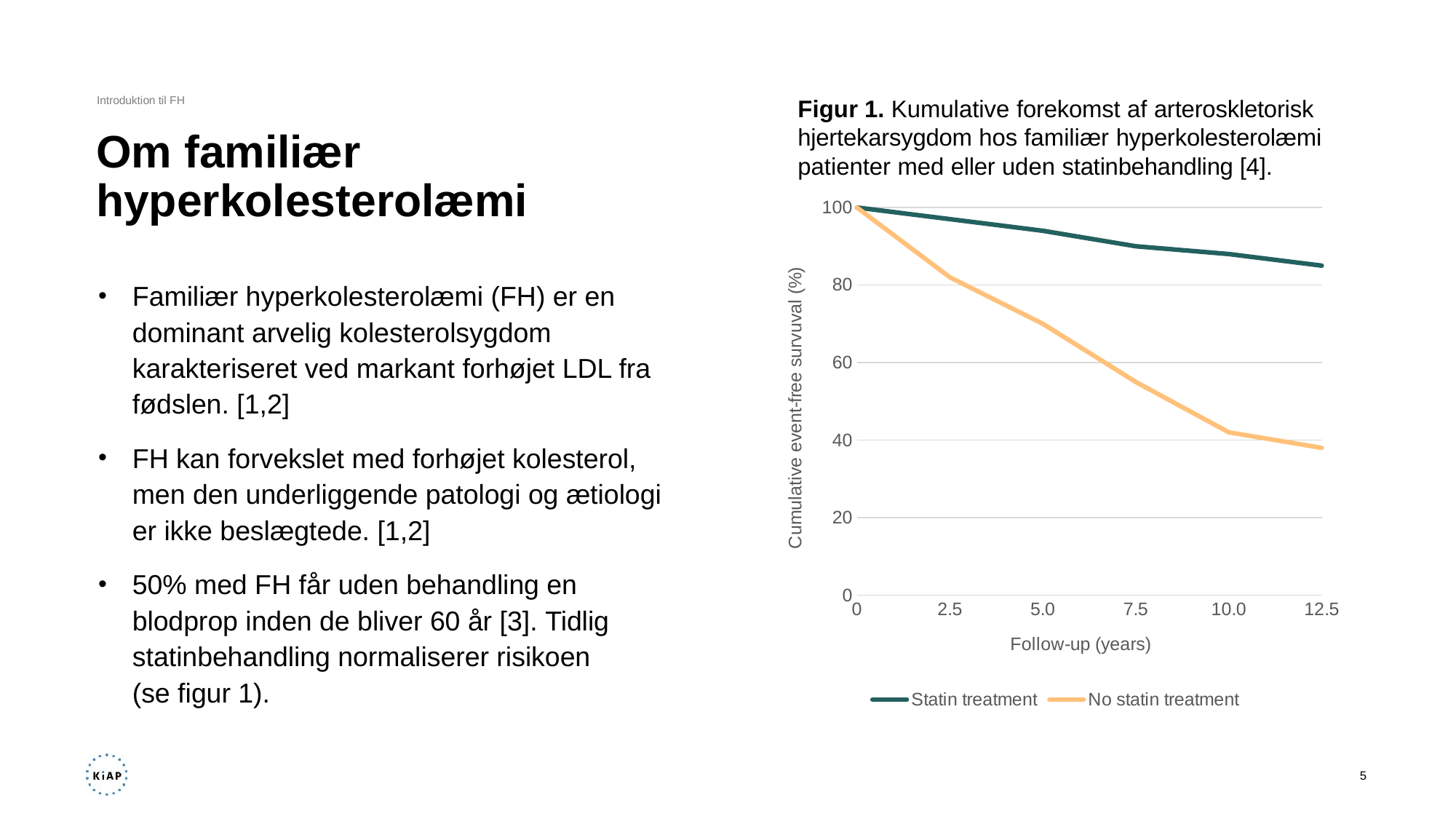
Which colour is used for the No statin treatment line in the chart? orange Is the value for Statin treatment at 7.5 years greater or less than 80? greater Is the value for No statin treatment at 12.5 years greater or less than 40? less What is the value of the Statin treatment series at follow-up year 0? 100 What kind of chart is shown in Figur 1? line chart What is the label of the y axis of the chart? Cumulative event-free survuval (%) Do the values of the No statin treatment series rise or fall as follow-up years increase? fall How many series does the legend of the chart list? 2 Is the value for Statin treatment at 12.5 years greater or less than 80? greater At 12.5 years of follow-up, which series has the higher value: Statin treatment or No statin treatment? Statin treatment What is the value of the No statin treatment series at follow-up year 0? 100